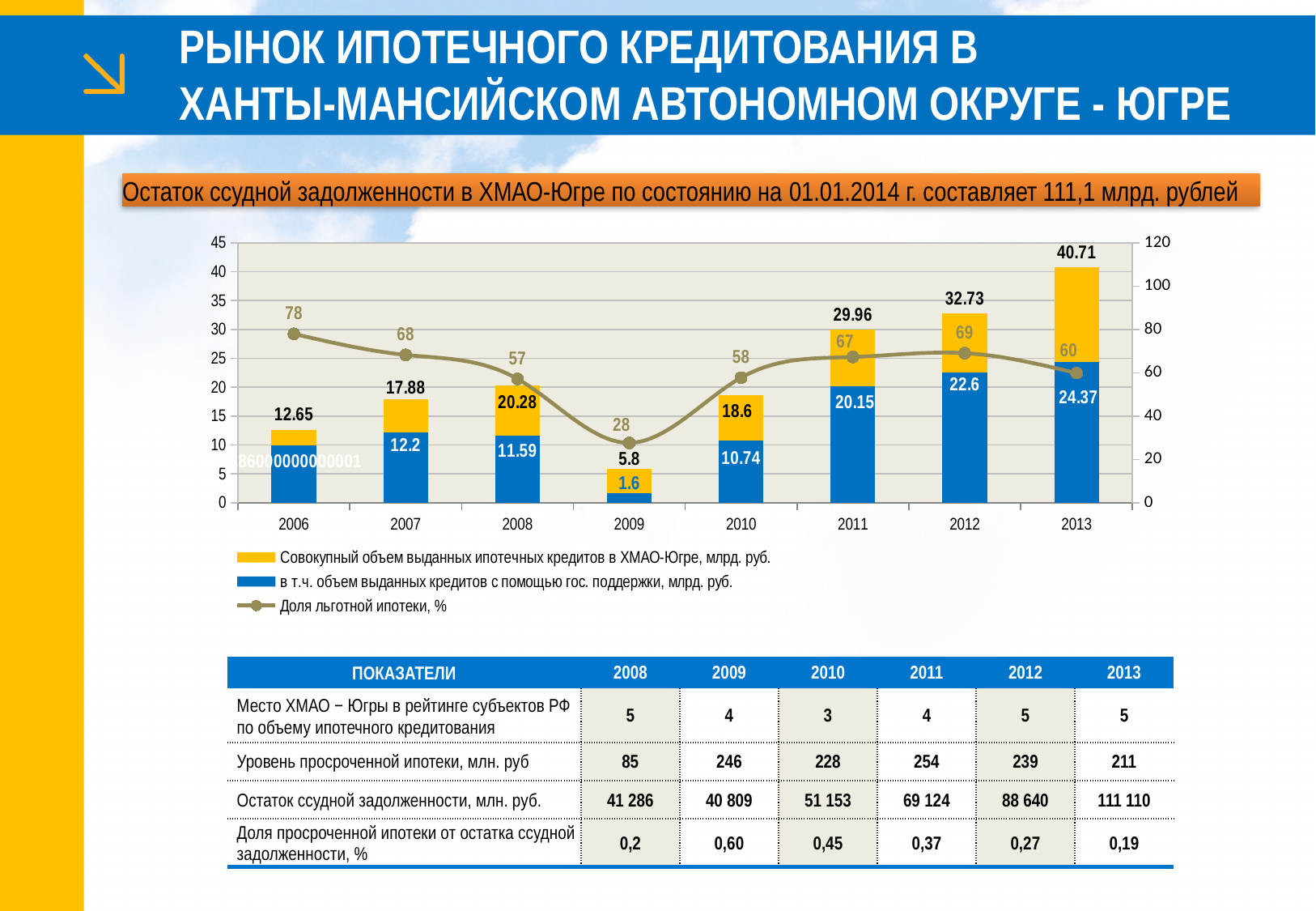
What is the difference between the 'Совокупный объем выданных ипотечных кредитов' values for 2013 and 2012? 7.98 What is the value of 'Доля льготной ипотеки, %' for 2009? 28 How many years are shown on the x axis of the chart? 8 Does the 'Совокупный объем выданных ипотечных кредитов' series rise or fall from 2010 to 2013? Rise How many series does the chart legend list? 3 Which year has the lowest value of 'Совокупный объем выданных ипотечных кредитов в ХМАО-Югре, млрд. руб.'? 2009 Which year has the highest value of 'Доля льготной ипотеки, %'? 2006 What is the value of 'Совокупный объем выданных ипотечных кредитов в ХМАО-Югре, млрд. руб.' for 2013? 40.71 What colour are the bars for 'в т.ч. объем выданных кредитов с помощью гос. поддержки, млрд. руб.'? Blue Which is larger: the 'Доля льготной ипотеки, %' value for 2012 or for 2013? 2012 What kind of chart is shown on the slide? Combined bar and line chart What is the value of 'в т.ч. объем выданных кредитов с помощью гос. поддержки, млрд. руб.' for 2011? 20.15